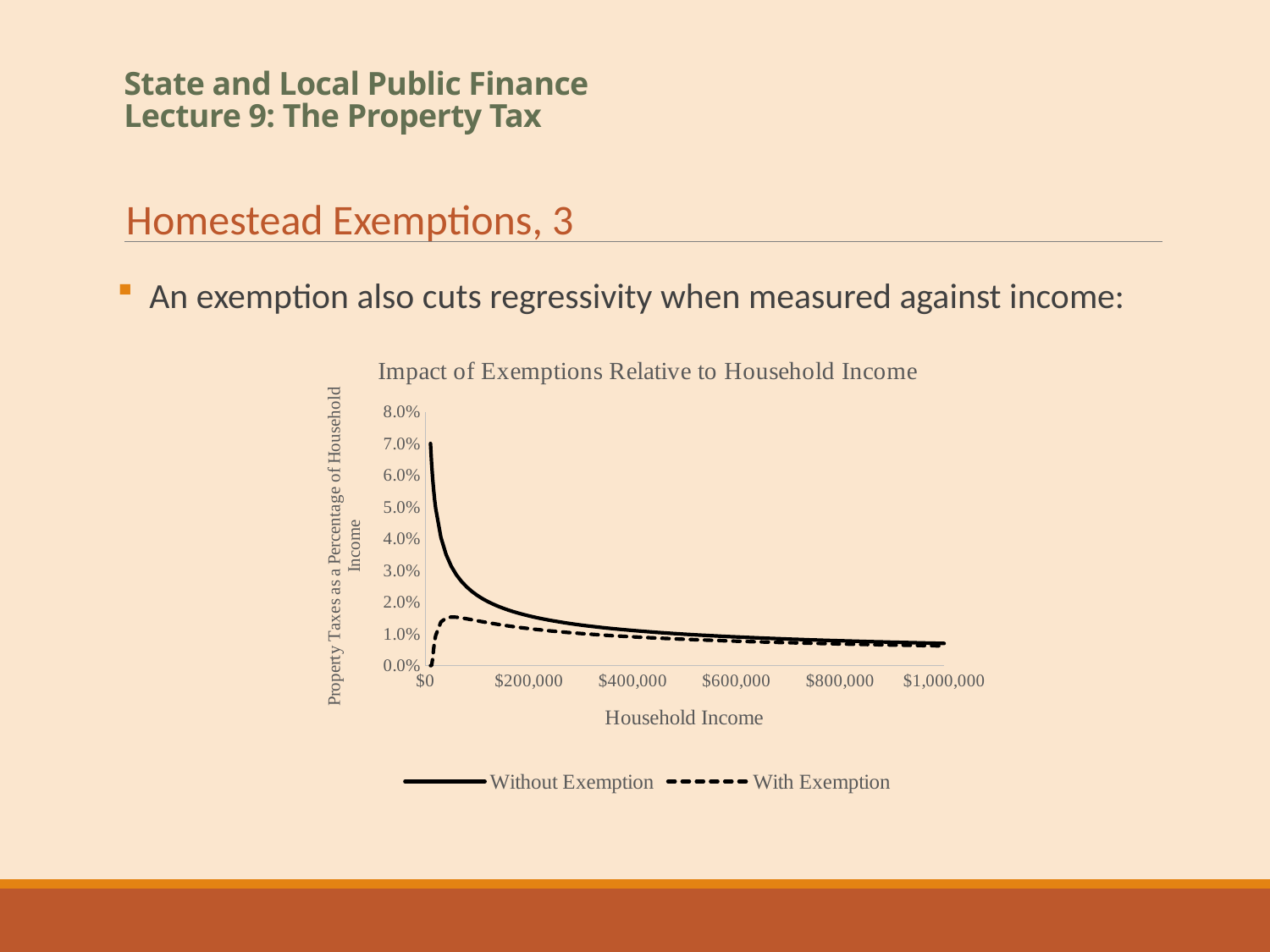
How many labelled tick marks are on the Household Income axis? 6 Which series is drawn with a dashed line? With Exemption Is the highest point of the Without Exemption line greater or less than 6.0%? greater Is the Without Exemption value at a household income of $200,000 greater or less than 1.0%? greater What is the title of the chart? Impact of Exemptions Relative to Household Income Is the With Exemption value at a household income of $200,000 greater or less than 2.0%? less How many series does the legend list? 2 At a household income of $200,000, which series has the higher value, Without Exemption or With Exemption? Without Exemption Does the Without Exemption line rise or fall as household income increases? fall What kind of chart is shown on the slide? line chart